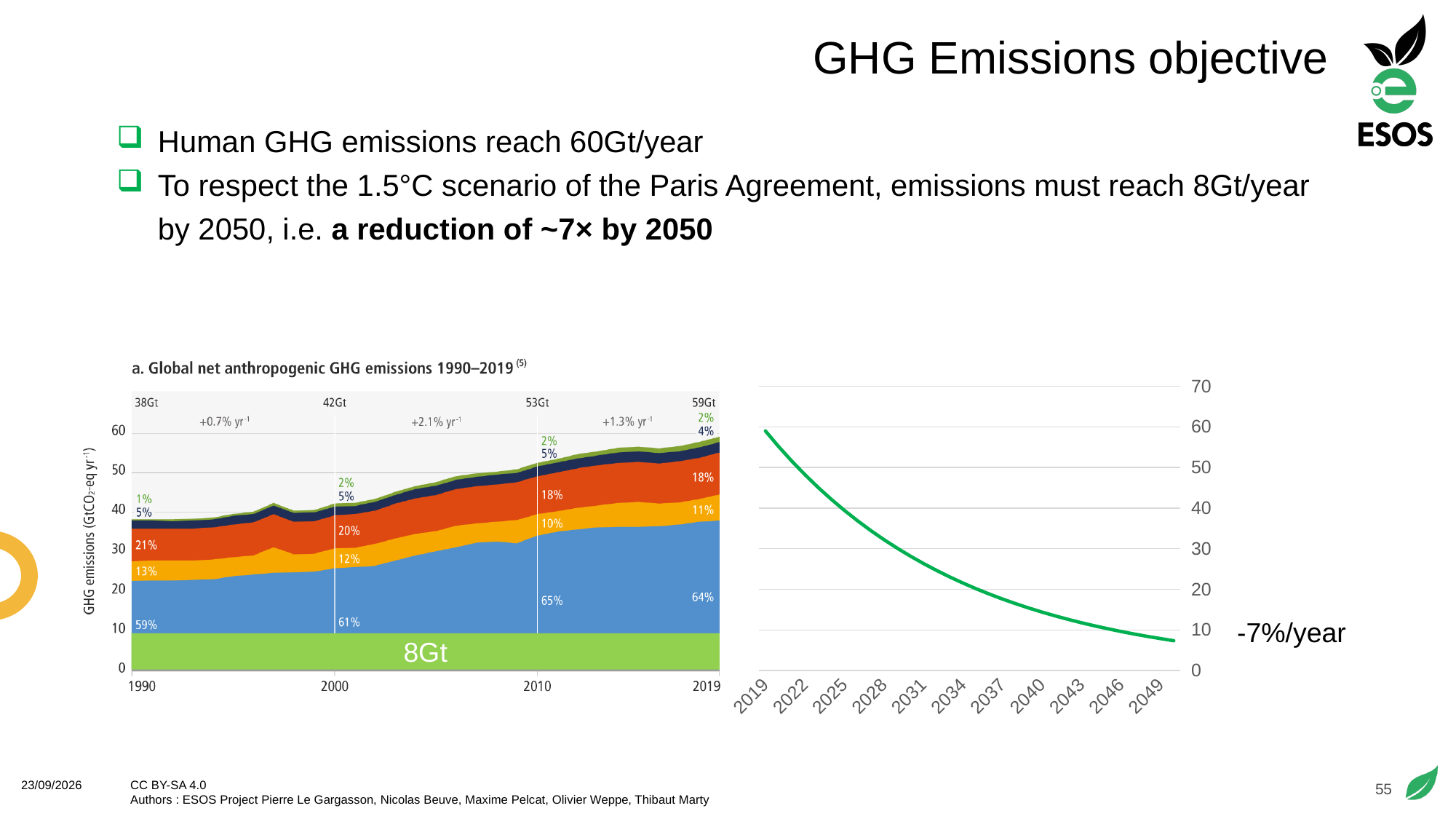
In the left chart 'Global net anthropogenic GHG emissions 1990–2019', what is the difference between the 2019 total and the 2010 total? 6Gt In the right-hand chart (2019–2049), is the value for 2019 greater or less than 50? greater In the right-hand chart (2019–2049), do the values rise or fall along the x axis? fall In the left chart 'Global net anthropogenic GHG emissions 1990–2019', what total emissions value is printed for 2019? 59Gt What type of chart is the right-hand chart (2019–2049)? line chart In the left chart 'Global net anthropogenic GHG emissions 1990–2019', is the total for 2000 larger or smaller than the total for 2010? smaller What annual rate of change is written next to the right-hand chart? -7%/year In the left chart 'Global net anthropogenic GHG emissions 1990–2019', what total emissions value is printed for 1990? 38Gt In the right-hand chart (2019–2049), is the value for 2049 greater or less than 10? less In the left chart 'Global net anthropogenic GHG emissions 1990–2019', what share does the blue (bottom) area have in 2010? 65% In the left chart 'Global net anthropogenic GHG emissions 1990–2019', which of the four labelled years has the highest total emissions? 2019 In the left chart 'Global net anthropogenic GHG emissions 1990–2019', what annual growth rate is printed for the period between 2000 and 2010? +2.1% yr⁻¹